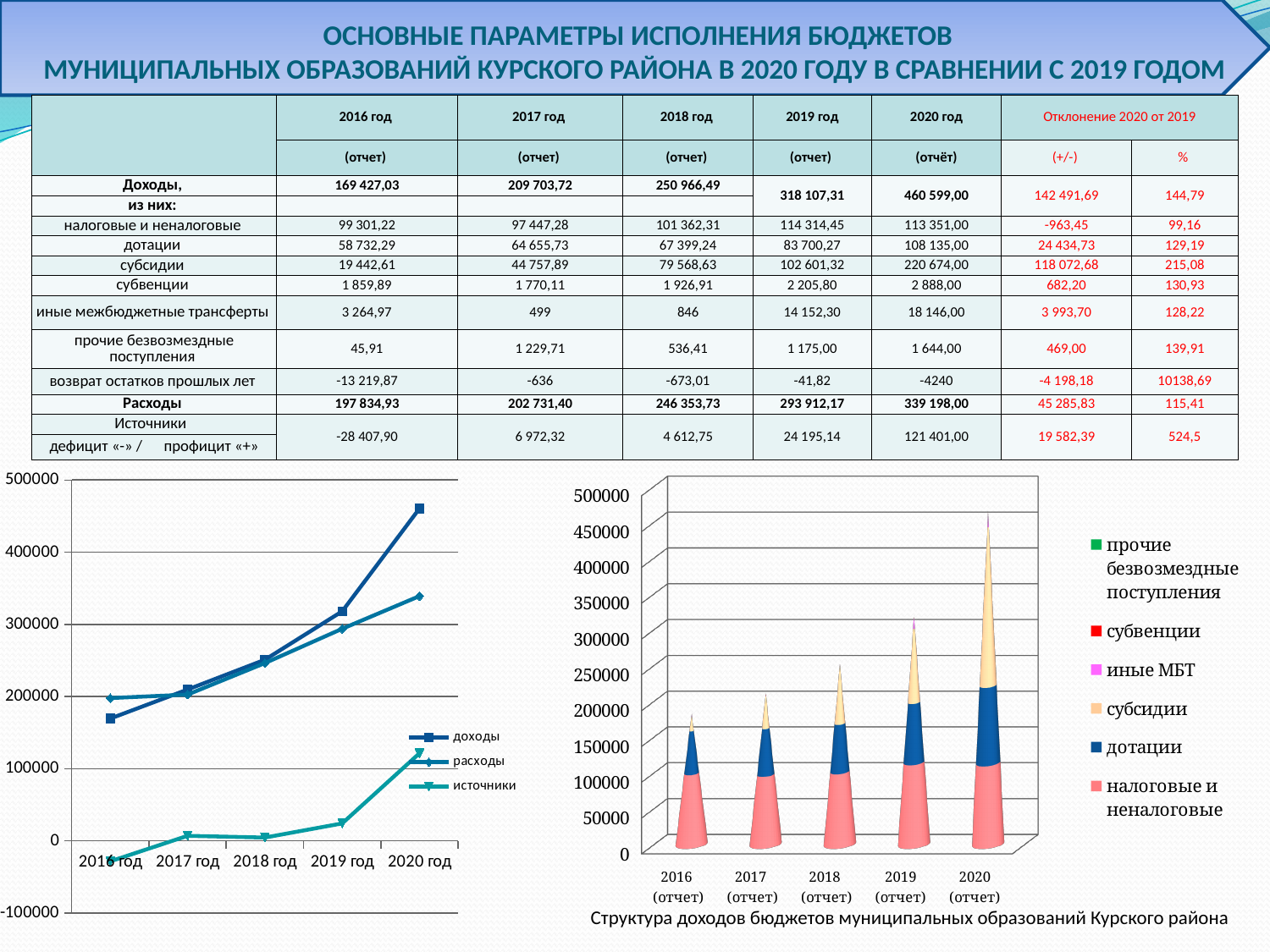
How many series does the legend of the bottom-left line chart list? 3 How many years are shown on the x axis of the bottom-left line chart? 5 In the bottom-left line chart, is the value for доходы in 2016 год greater or less than 200000? less In the chart titled 'Структура доходов бюджетов муниципальных образований Курского района', which year has the tallest stack? 2020 (отчет) In the bottom-left line chart, which is larger in 2016 год: доходы or расходы? расходы What kind of chart is the chart at the bottom left of the slide? line chart In the bottom-left line chart, which series reaches the highest value in 2020 год? доходы How many series does the legend of the chart titled 'Структура доходов бюджетов муниципальных образований Курского района' list? 6 In the chart titled 'Структура доходов бюджетов муниципальных образований Курского района', which legend entry is shown in dark blue? дотации In the bottom-left line chart, is the value for источники in 2016 год greater or less than 0? less In the bottom-left line chart, does the доходы series rise or fall from 2016 год to 2020 год? rise In the bottom-left line chart, is the value for доходы in 2020 год greater or less than 400000? greater